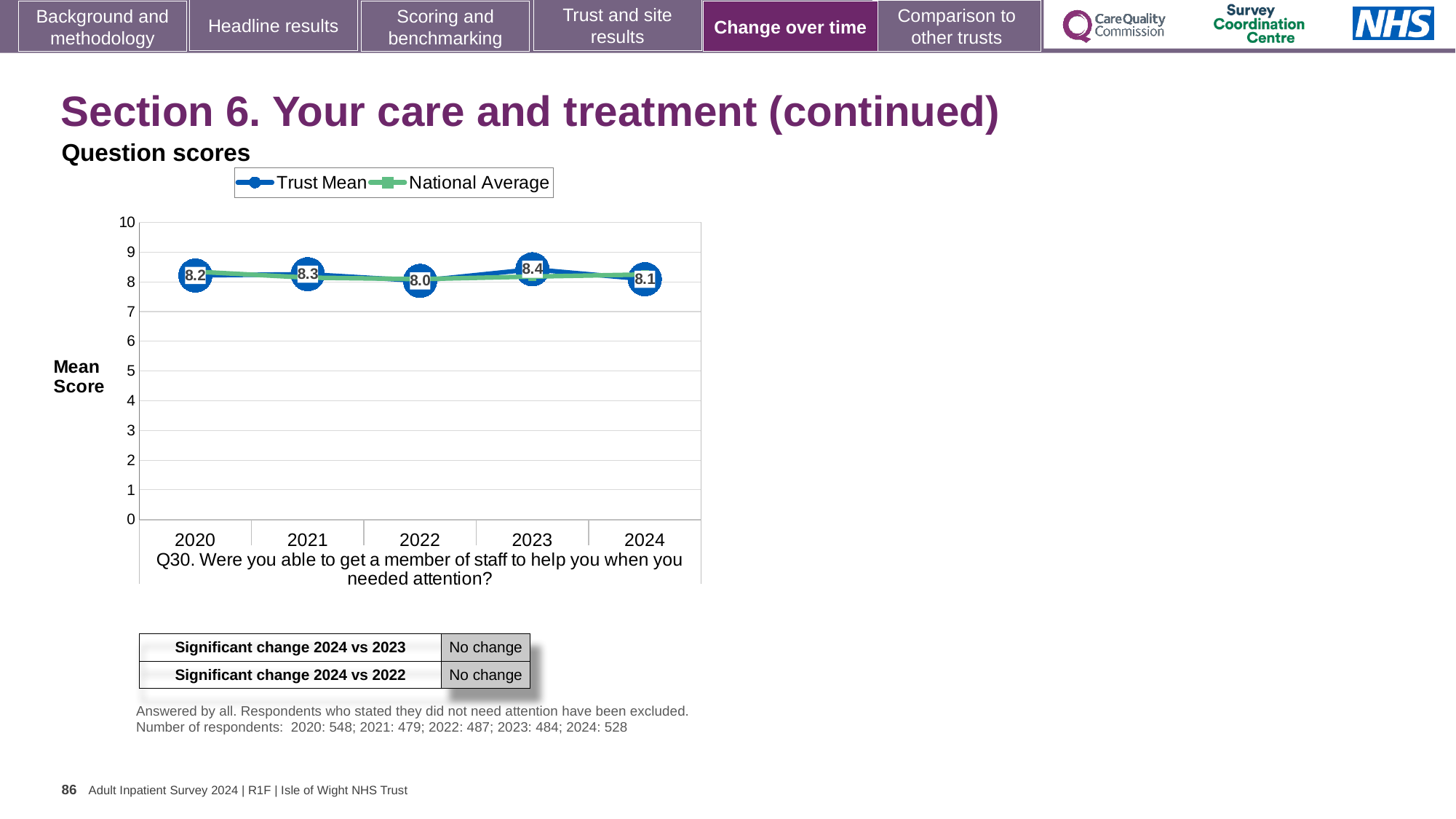
What is the label of the y axis? Mean Score What is the Trust Mean score for 2020? 8.2 Which year has the larger Trust Mean score, 2021 or 2024? 2021 What is the Trust Mean score for 2022? 8.0 How many series does the legend list? 2 In which year is the Trust Mean score lowest? 2022 What is the difference between the Trust Mean scores for 2023 and 2022? 0.4 In which year is the Trust Mean score highest? 2023 Is the Trust Mean score for 2023 greater or less than 7? greater What is the Trust Mean score for 2024? 8.1 What kind of chart is shown on the slide? Line chart How many years are plotted on the x axis? 5